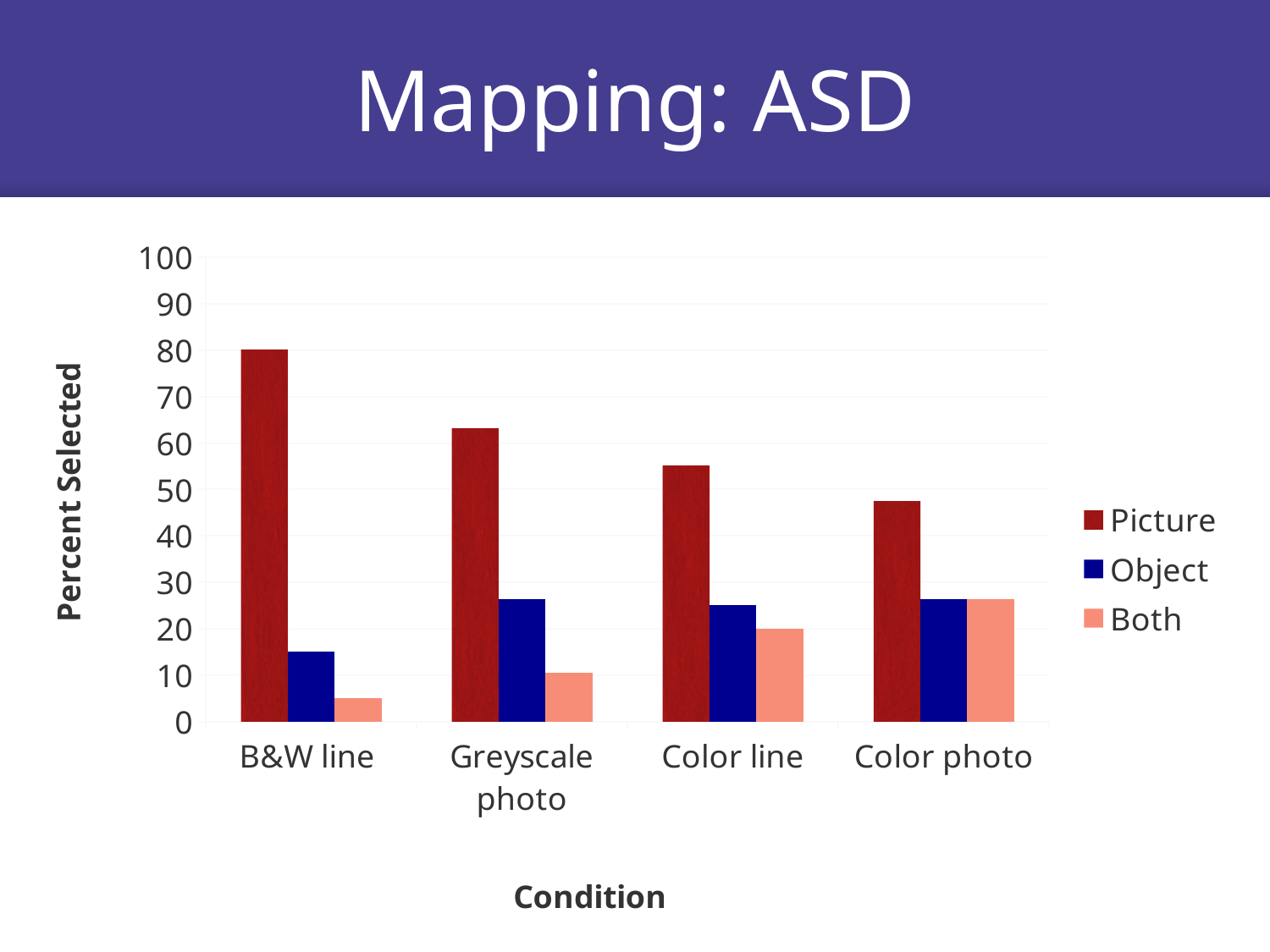
What is the label of the y axis? Percent Selected Do the Picture values rise or fall from B&W line to Color photo? fall Is the Picture value for Color photo greater or less than 50? less Which condition has the lowest Both value? B&W line Is the Picture value for Greyscale photo greater or less than 60? greater Do the Both values rise or fall from B&W line to Color photo? rise How many series does the legend list? 3 What kind of chart is shown on the slide? bar chart How many conditions are shown on the x axis? 4 Which is larger for Color line: the Object value or the Both value? Object Is the Both value for B&W line greater or less than 10? less Which condition has the highest Picture value? B&W line